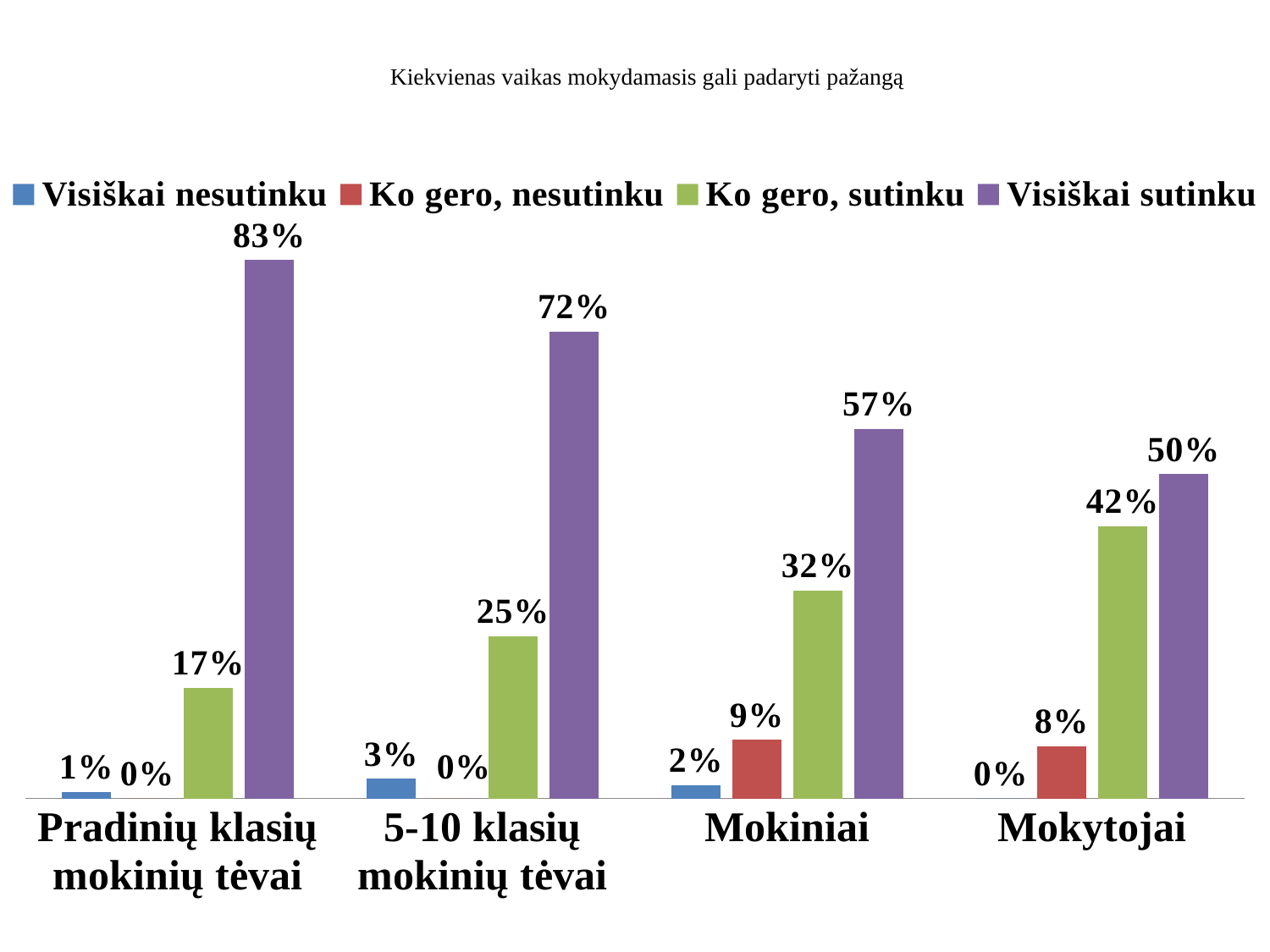
What is the value of "Ko gero, nesutinku" for "Mokiniai"? 9% What kind of chart is shown on the slide? Bar chart Which is larger: "Ko gero, sutinku" for "Mokiniai" or "Ko gero, sutinku" for "Mokytojai"? Mokytojai What is the title of the chart? Kiekvienas vaikas mokydamasis gali padaryti pažangą What is the value of "Ko gero, sutinku" for "Mokytojai"? 42% What is the difference between the "Visiškai sutinku" values for "5-10 klasių mokinių tėvai" and "Mokytojai"? 22% Which category has the lowest value for "Ko gero, sutinku"? Pradinių klasių mokinių tėvai What is the value of "Visiškai sutinku" for "Pradinių klasių mokinių tėvai"? 83% How many categories are shown on the x axis? 4 What is the value of "Visiškai nesutinku" for "5-10 klasių mokinių tėvai"? 3% How many series does the legend list? 4 Which category has the highest value for "Visiškai sutinku"? Pradinių klasių mokinių tėvai